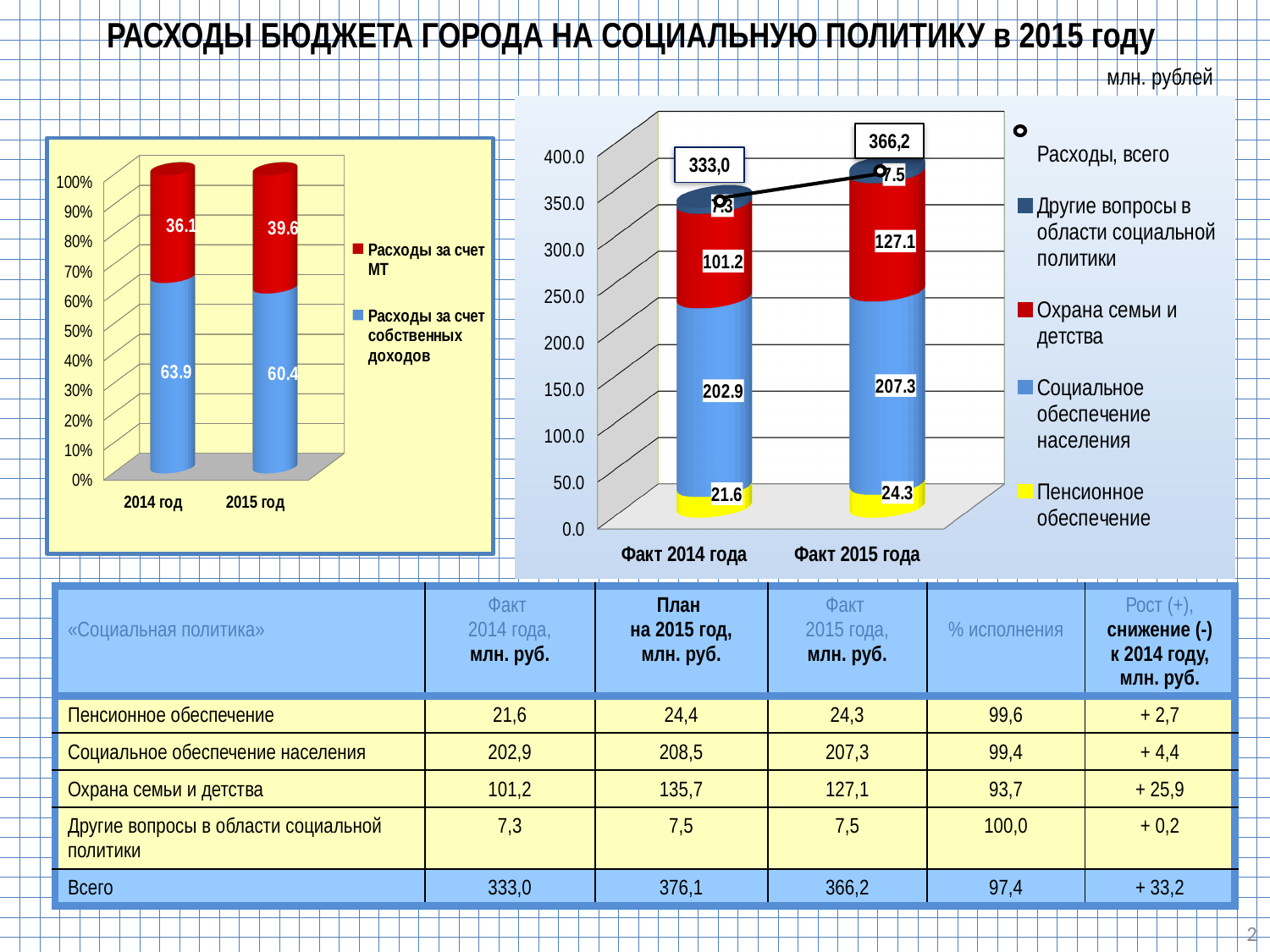
In the left chart, which year has the larger value for 'Расходы за счет собственных доходов', 2014 год or 2015 год? 2014 год In the right chart, does the total 'Расходы, всего' rise or fall from Факт 2014 года to Факт 2015 года? rise In the right chart, which category has the highest value for Факт 2015 года? Социальное обеспечение населения What kind of chart is the right chart? stacked bar chart In the left chart, what is the value for 'Расходы за счет собственных доходов' in 2015 год? 60.4 In the left chart, what is the value for 'Расходы за счет МТ' in 2014 год? 36.1 In the right chart, what is the value for 'Пенсионное обеспечение' for Факт 2014 года? 21.6 In the right chart, what is the total 'Расходы, всего' for Факт 2015 года? 366,2 In the left chart, how many series does the legend list? 2 In the right chart, what is the difference between 'Охрана семьи и детства' for Факт 2015 года and Факт 2014 года? 25.9 In the right chart, what is the value for 'Социальное обеспечение населения' for Факт 2015 года? 207.3 In the right chart, which category has the lowest value for Факт 2014 года? Другие вопросы в области социальной политики